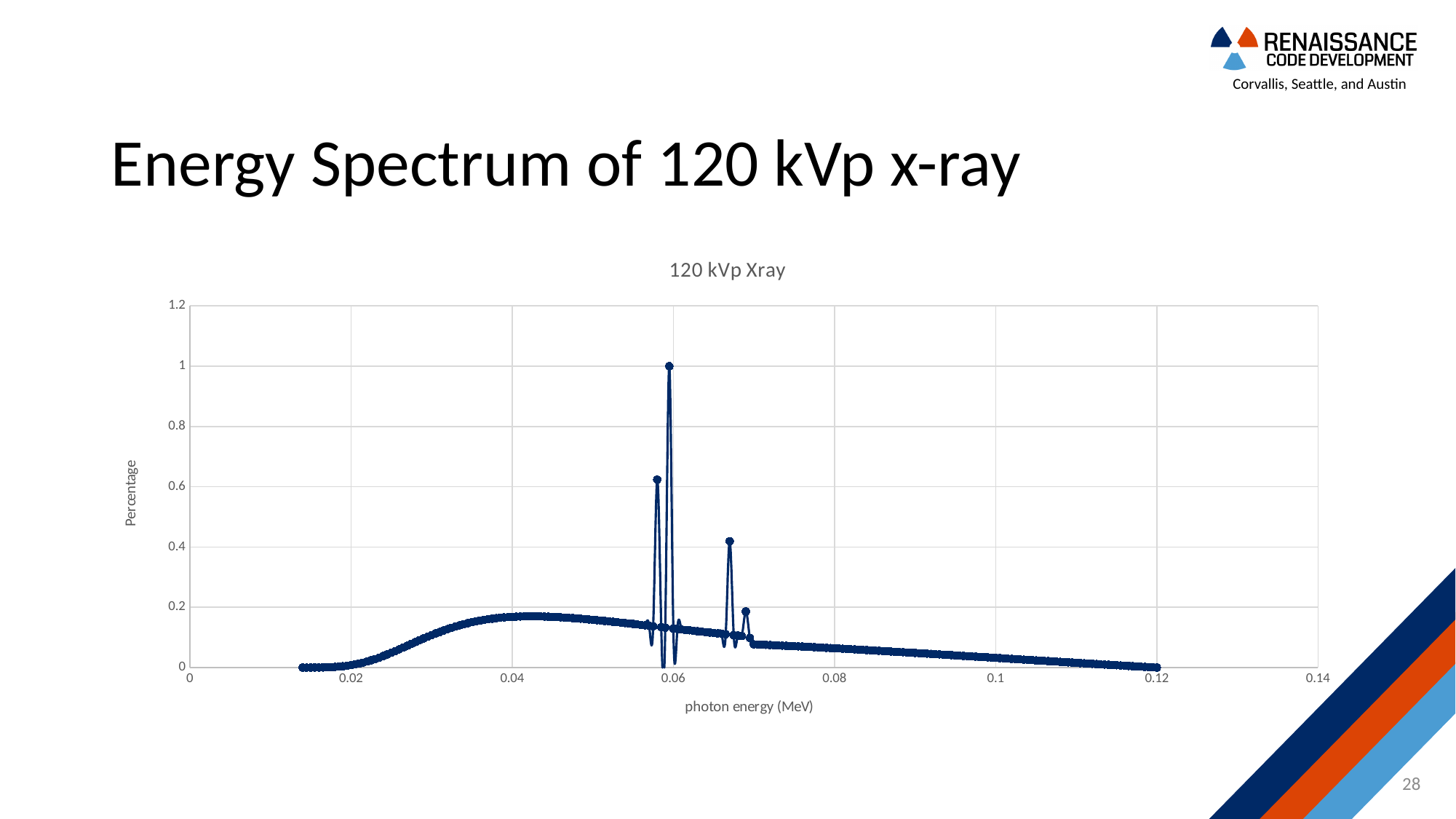
What kind of chart is shown on the slide? line chart Between 0.07 MeV and 0.12 MeV, do the plotted values rise or fall as photon energy increases? fall At what photon energy on the x axis does the plotted data end? 0.12 Is the tallest spike in the chart greater or less than 0.8? greater Is the spike near 0.067 MeV greater or less than 0.6? less Between 0.02 MeV and 0.04 MeV, do the plotted values rise or fall as photon energy increases? rise Is the value of the curve at 0.04 MeV greater or less than 0.2? less What is the highest value reached by the plotted curve? 1 What is the title of the chart? 120 kVp Xray Which is taller, the spike near 0.06 MeV or the spike near 0.067 MeV? the spike near 0.06 MeV What is the label of the x axis of the chart? photon energy (MeV)